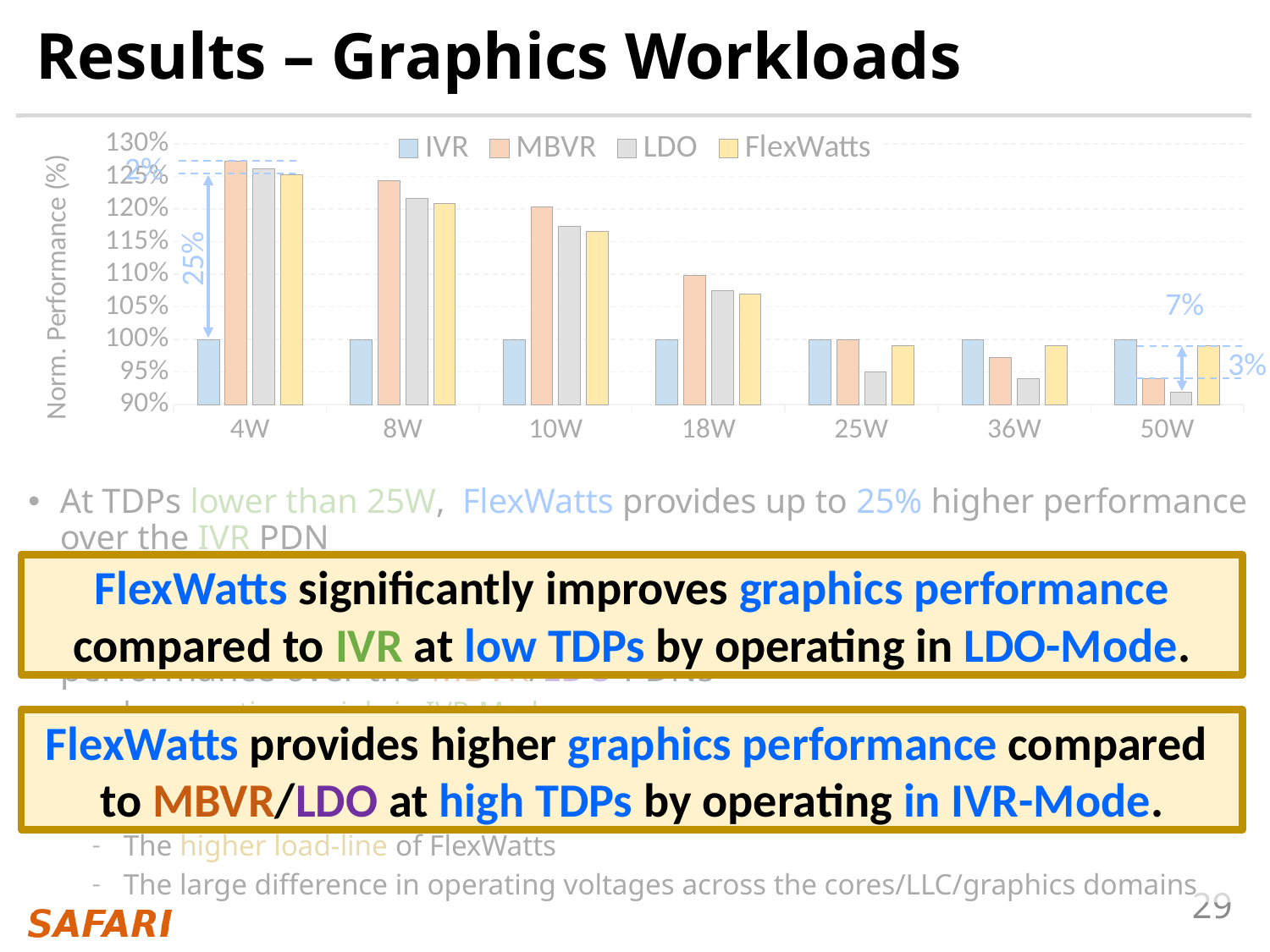
What kind of chart is shown on the slide? bar chart Do the MBVR values rise or fall as TDP increases from 4W to 50W? fall How many TDP categories are shown on the x axis of the chart? 7 What is the normalized performance of IVR at 4W? 100% What is the normalized performance of IVR at 50W? 100% Is the value for LDO at 36W greater or less than 100%? less How many series does the chart's legend list? 4 At 8W, which is larger: the value for MBVR or the value for LDO? MBVR Is the value for LDO at 50W greater or less than 95%? less Is the value for MBVR at 4W greater or less than 120%? greater At 25W, which series has the lowest normalized performance? LDO